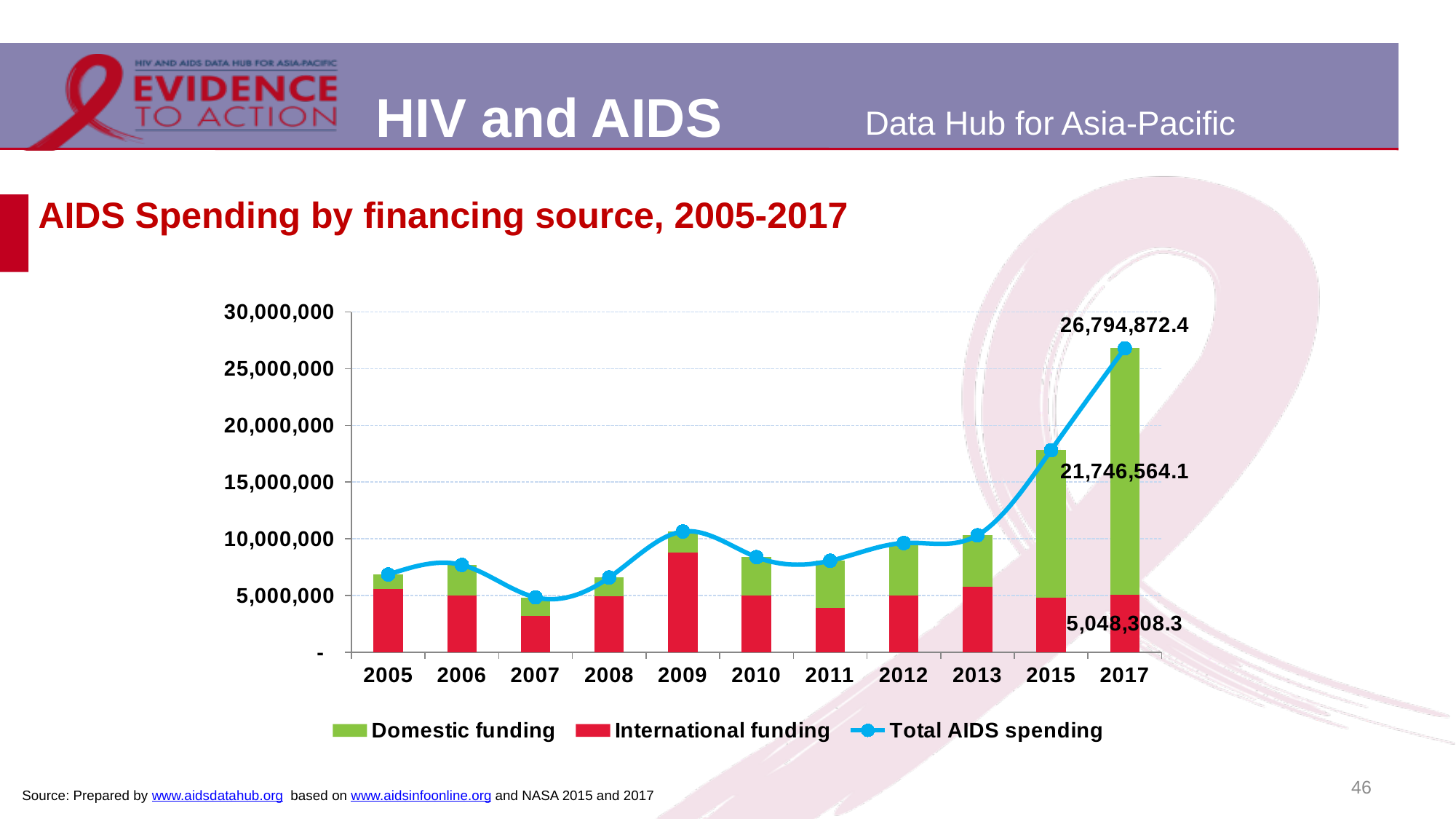
What is the international funding value in 2017? 5,048,308.3 What is the domestic funding value in 2017? 21,746,564.1 How many years are shown on the x axis? 11 How many series does the legend list? 3 What kind of chart is this? Stacked bar chart with a line In 2017, which is larger: domestic funding or international funding? Domestic funding What is the total AIDS spending in 2017? 26,794,872.4 In which year is international funding highest? 2009 In which year is total AIDS spending highest? 2017 Is the total AIDS spending for 2015 greater or less than 15,000,000? greater Is the international funding for 2007 greater or less than 5,000,000? less In which year is total AIDS spending lowest? 2007